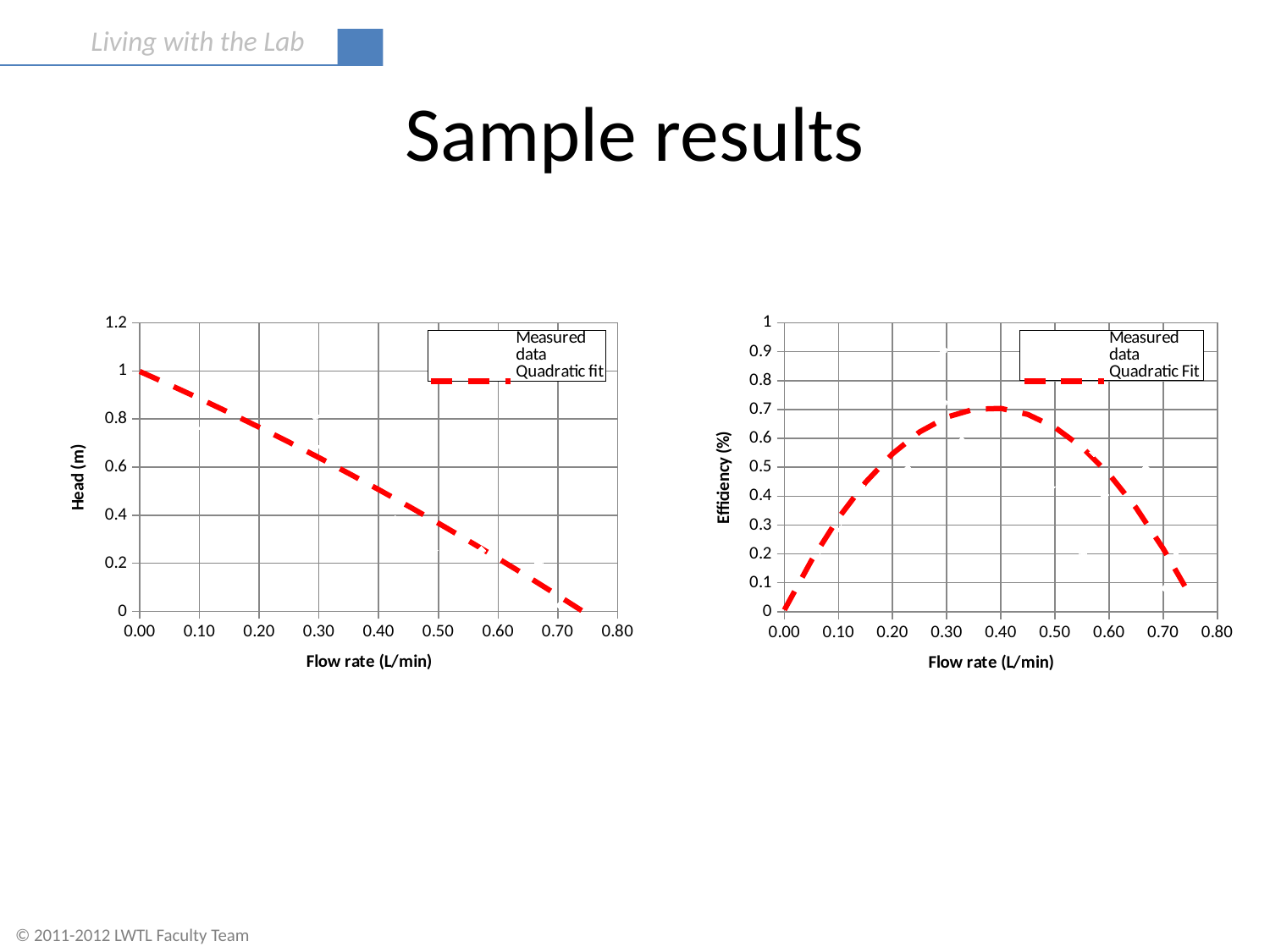
In the right chart, is the peak value of the quadratic fit greater or less than 0.8? less How many series does the legend of the right chart list? 2 In the right chart, does the quadratic fit rise or fall between flow rates of 0.50 and 0.70 L/min? fall In the right chart, does the quadratic fit rise or fall between flow rates of 0.00 and 0.30 L/min? rise In the left chart, does the quadratic fit rise or fall as flow rate increases? fall In the left chart, is the quadratic fit value of head at a flow rate of 0.70 L/min greater or less than 0.2? less What is the y-axis title of the right chart? Efficiency (%) What kind of chart is the right chart (Efficiency vs Flow rate)? line chart How many series does the legend of the left chart list? 2 In the right chart, is the quadratic fit value of efficiency at a flow rate of 0.50 L/min greater or less than 0.5? greater What kind of chart is the left chart (Head vs Flow rate)? line chart